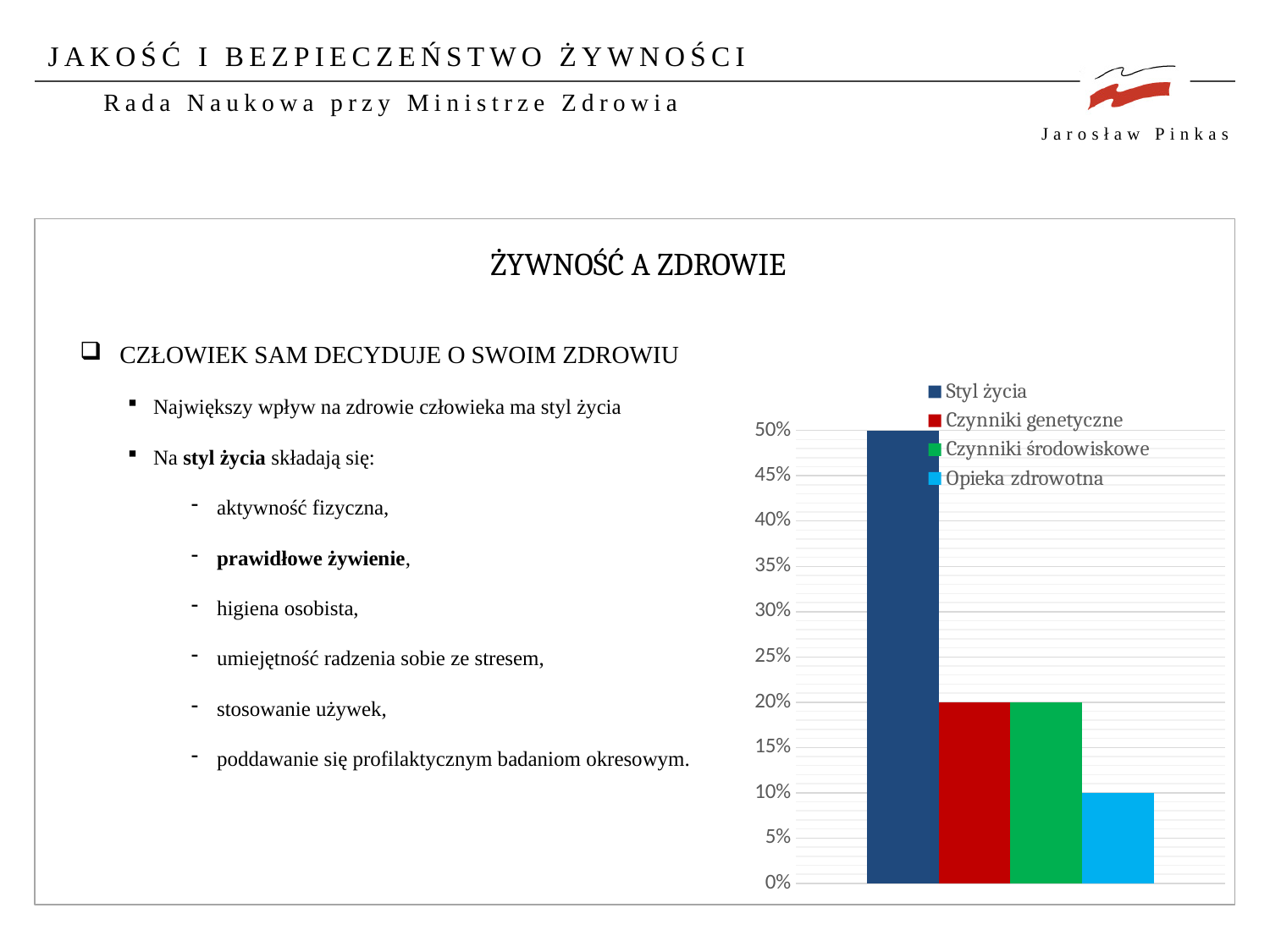
Which series has the highest value? Styl życia What colour is the bar for Czynniki genetyczne? red What is the value for Czynniki genetyczne? 20% How many series does the chart legend list? 4 What is the value for Styl życia? 50% Which series has the lowest value? Opieka zdrowotna What is the value for Opieka zdrowotna? 10% How many bars are plotted in the chart? 4 What kind of chart is shown on the slide? bar chart What is the difference between the values for Styl życia and Opieka zdrowotna? 40% Is the value for Czynniki środowiskowe greater or less than 30%? less Which is larger, the value for Styl życia or the value for Czynniki środowiskowe? Styl życia